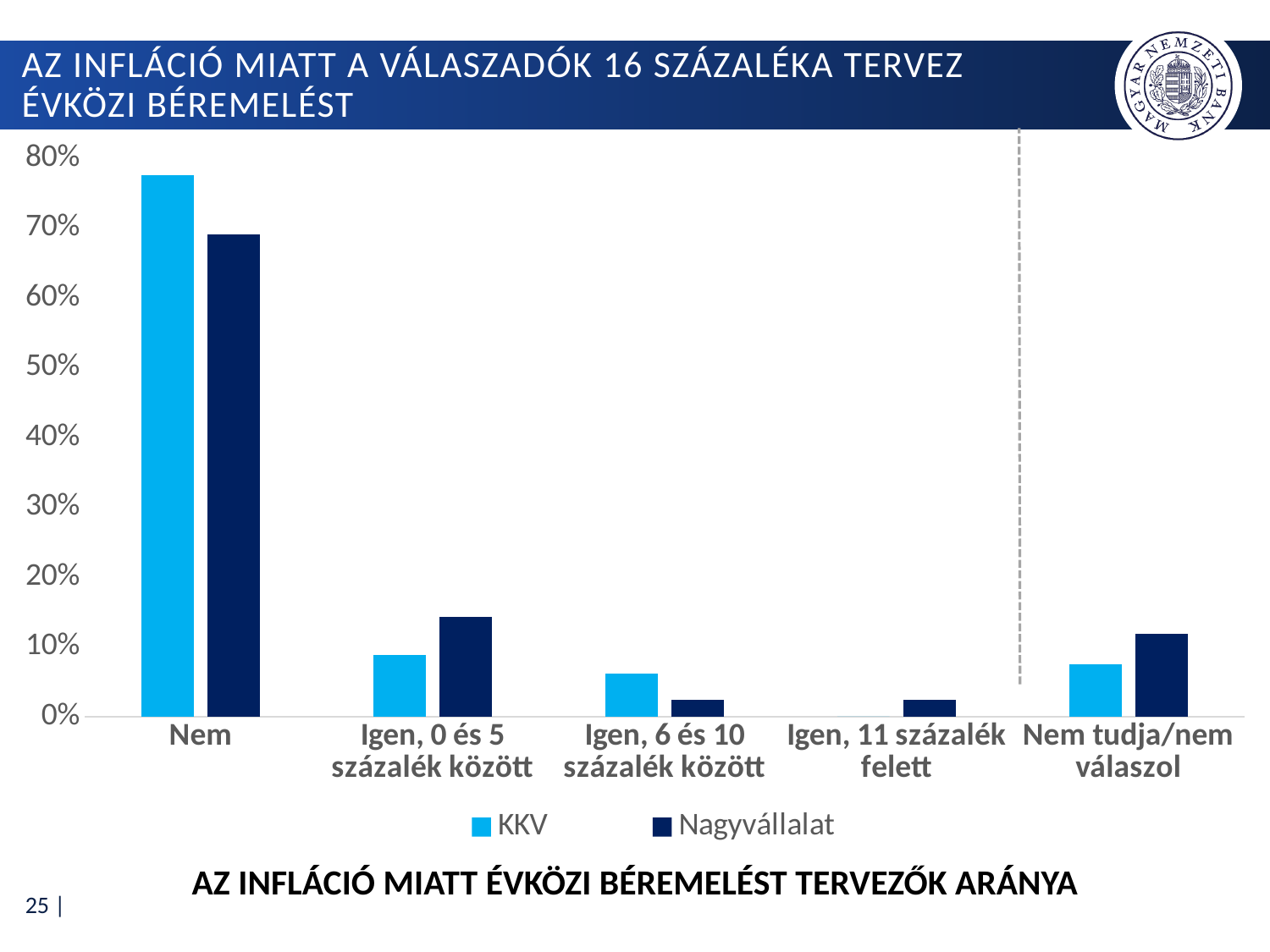
For the category 'Igen, 0 és 5 százalék között', which series has the larger value, KKV or Nagyvállalat? Nagyvállalat For the category 'Nem tudja/nem válaszol', which series has the larger value, KKV or Nagyvállalat? Nagyvállalat How many categories are shown on the x axis of the chart? 5 What kind of chart is shown on the slide? bar chart Which category has the highest value for the KKV series? Nem Is the Nagyvállalat value for 'Igen, 0 és 5 százalék között' greater or less than 10%? greater How many series does the legend list? 2 Which series are listed in the legend? KKV and Nagyvállalat Which category has the highest value for the Nagyvállalat series? Nem For the category 'Nem', which series has the larger value, KKV or Nagyvállalat? KKV Which category has the lowest value for the KKV series? Igen, 11 százalék felett Is the KKV value for 'Nem' greater or less than 70%? greater